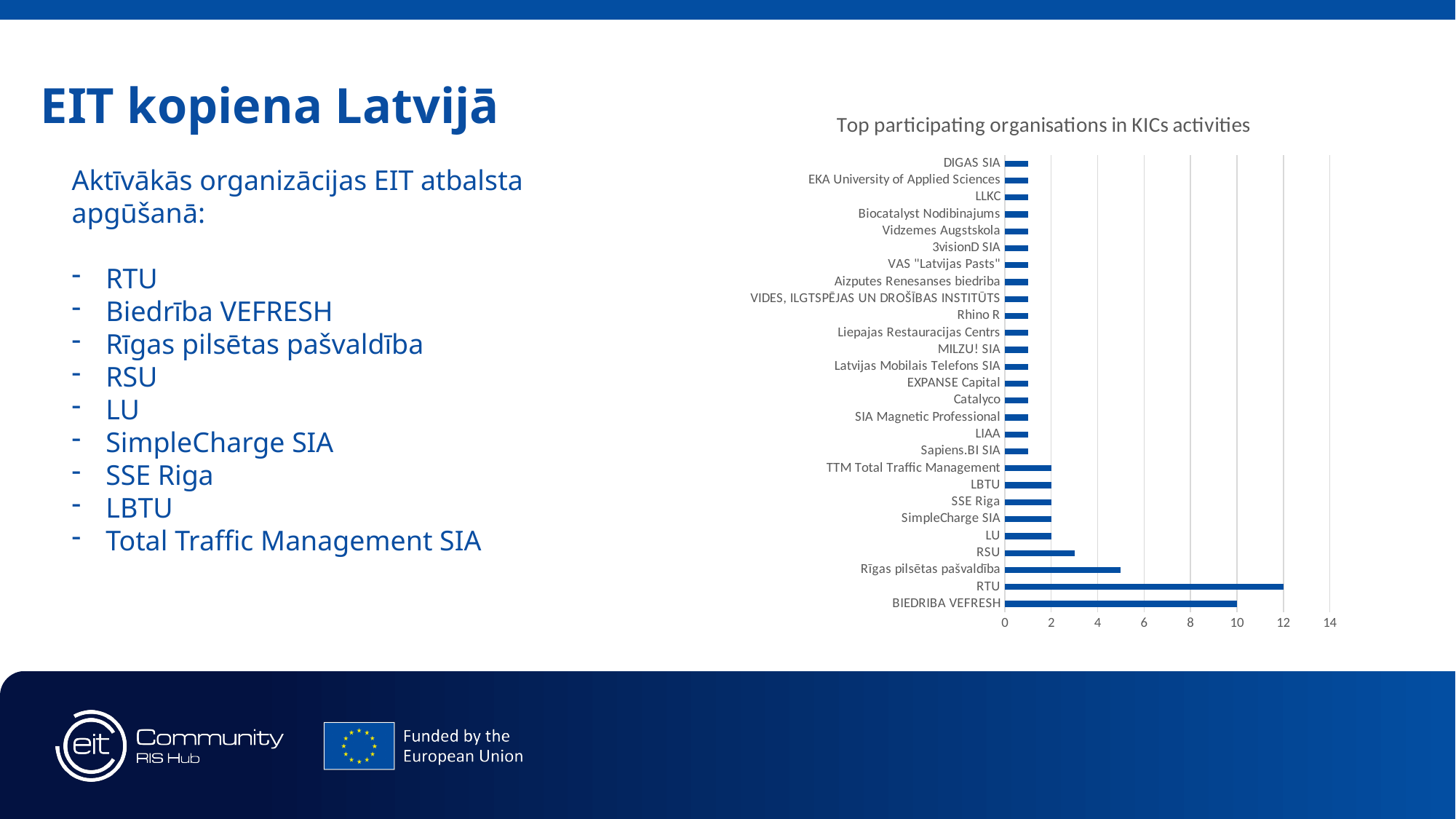
What kind of chart is shown on the slide? bar chart Is the value for DIGAS SIA greater or less than 2? less What is the title of the chart? Top participating organisations in KICs activities What is the value for BIEDRIBA VEFRESH? 10 What is the value for SSE Riga? 2 Which is larger, the value for RSU or the value for LBTU? RSU What is the value for LU? 2 What is the difference between the values for RTU and BIEDRIBA VEFRESH? 2 Which organisation has the highest value in the chart? RTU How many organisations are listed in the chart? 27 Is the value for Rīgas pilsētas pašvaldība greater or less than 4? greater What is the value for RTU? 12